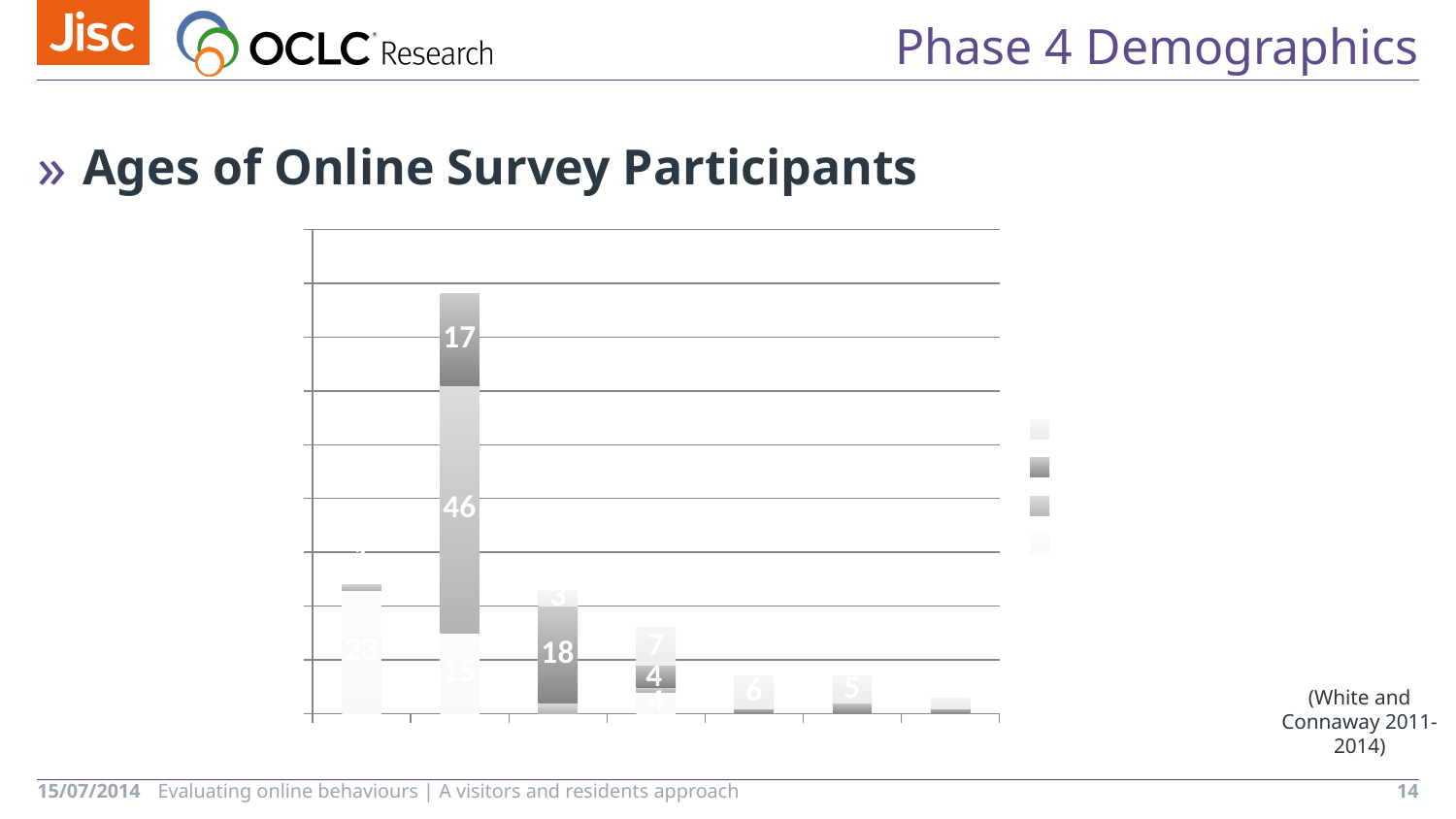
What is the difference between the 46 segment and the 17 segment in the second bar from the left? 29 What heading appears above the chart on the slide? Ages of Online Survey Participants What value is printed on the middle segment of the second bar from the left? 46 What value is printed on the top (darkest) segment of the second bar from the left? 17 Which is larger: the 46 segment or the 17 segment in the second bar from the left? 46 What kind of chart is shown on the slide? stacked bar chart What value is printed on the dark segment of the third bar from the left? 18 How many bars are plotted in the chart? 7 Which bar is the tallest in the chart? the second bar from the left How many entries does the chart's legend show? 4